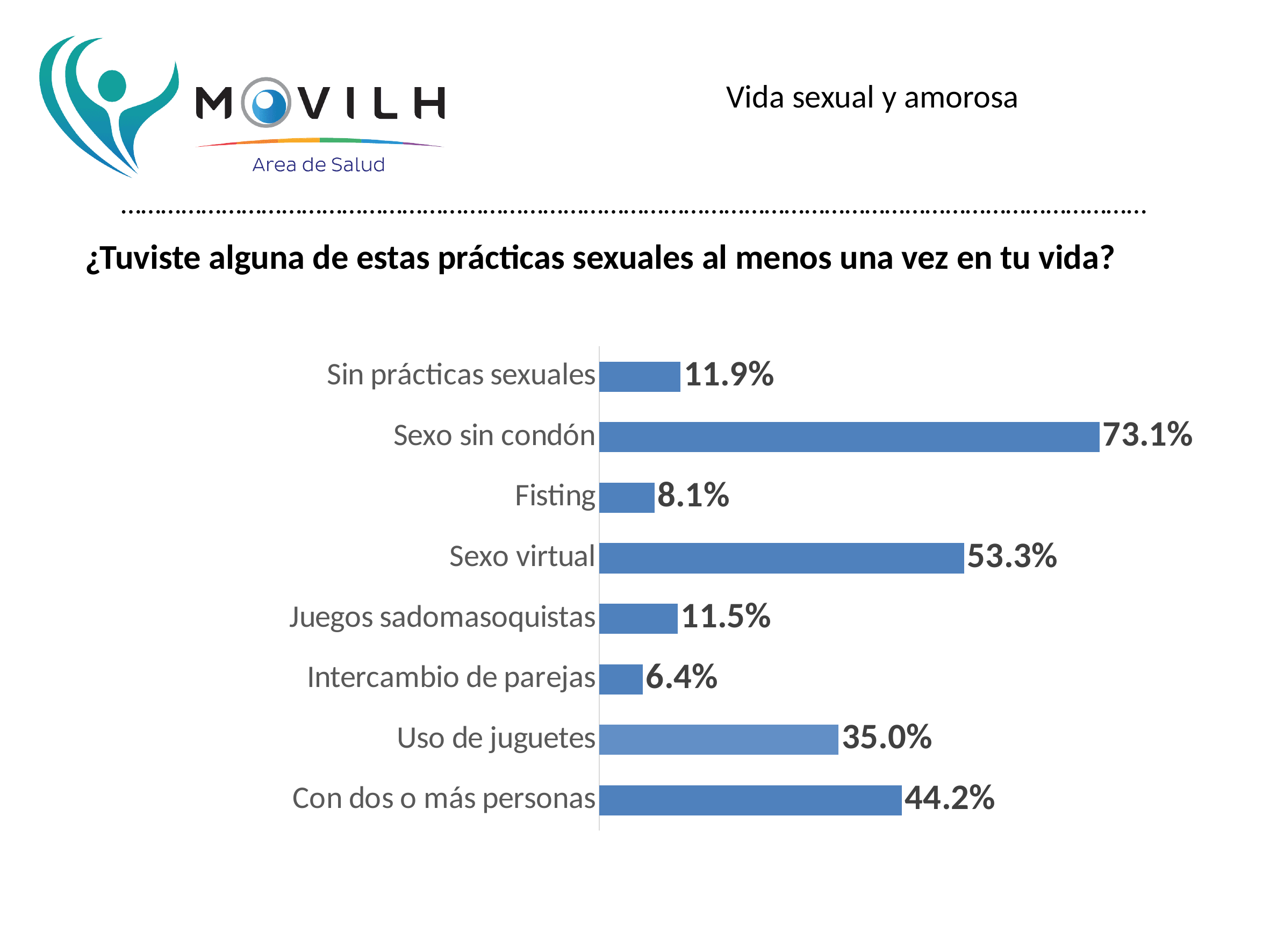
What percentage is shown for "Sexo sin condón"? 73.1% What percentage is shown for "Sin prácticas sexuales"? 11.9% What question is the chart titled with? ¿Tuviste alguna de estas prácticas sexuales al menos una vez en tu vida? What percentage is shown for "Intercambio de parejas"? 6.4% What kind of chart is shown on the slide? Bar chart Which category has the highest percentage? Sexo sin condón What is the difference in percentage points between "Con dos o más personas" and "Uso de juguetes"? 9.2 What is the difference in percentage points between "Sexo sin condón" and "Sexo virtual"? 19.8 Which category has the lowest percentage? Intercambio de parejas Which is larger, the value for "Fisting" or the value for "Juegos sadomasoquistas"? Juegos sadomasoquistas What percentage is shown for "Uso de juguetes"? 35.0% How many categories are shown in the chart? 8